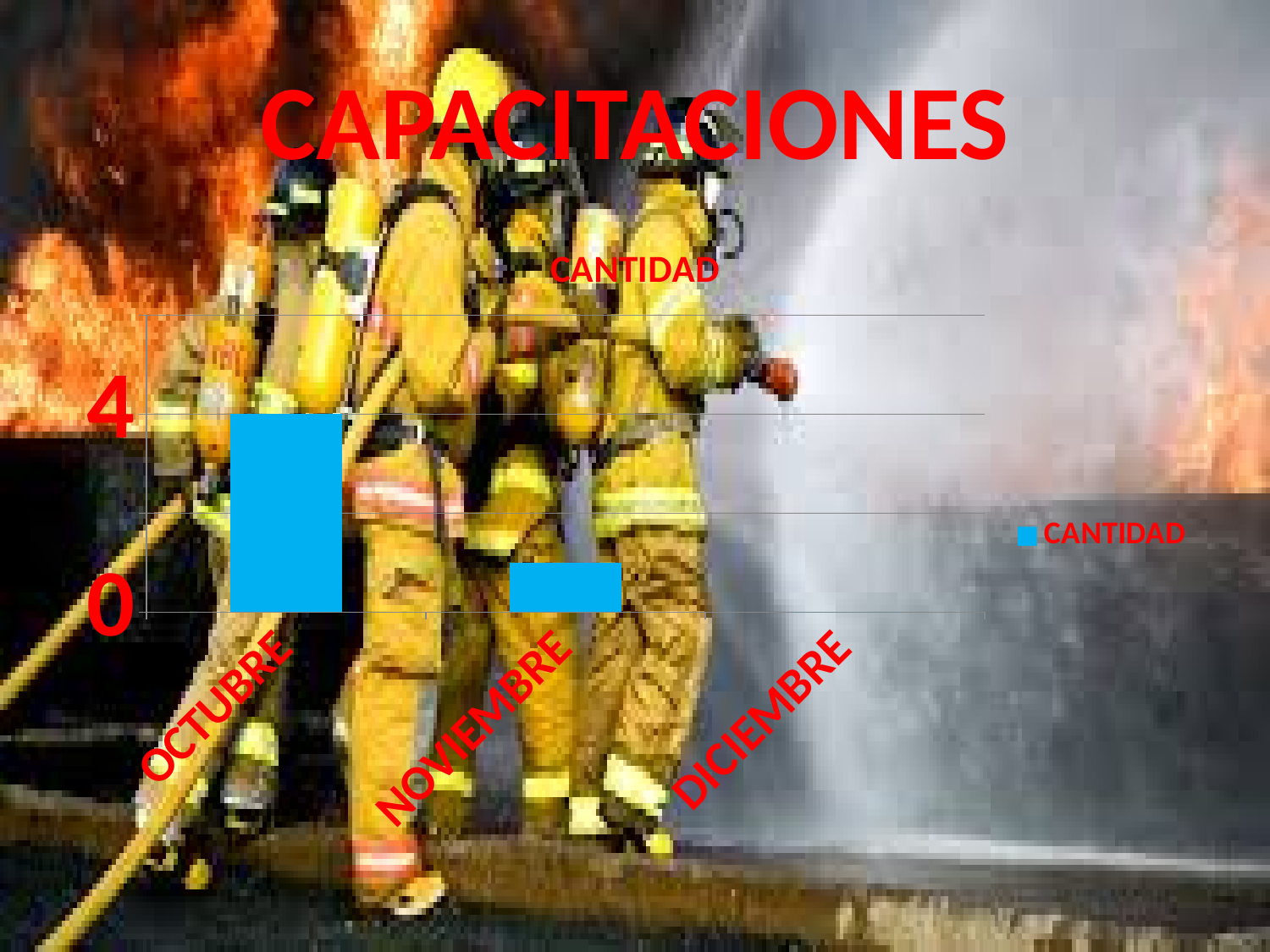
What is the name of the series shown in the legend? CANTIDAD What is the value for OCTUBRE? 4 Do the values rise or fall from OCTUBRE to NOVIEMBRE? fall Which category has the highest value in the chart? OCTUBRE Is the value for NOVIEMBRE greater or less than 4? less Which is larger, the value for OCTUBRE or the value for NOVIEMBRE? OCTUBRE How many categories are shown on the x axis of the chart? 3 What kind of chart is shown on the slide? bar chart What is the title of the chart? CANTIDAD How many series does the chart's legend list? 1